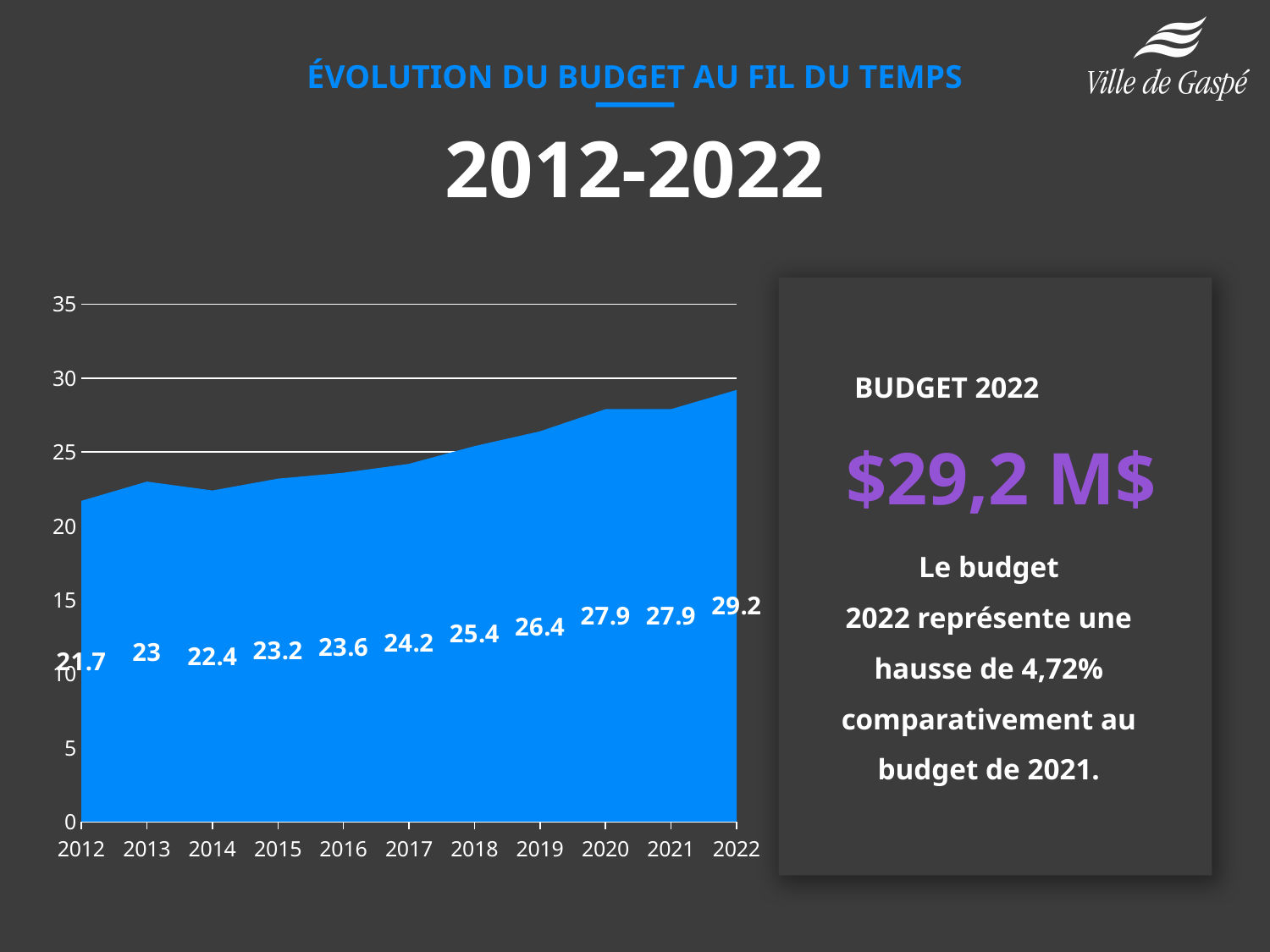
Which year has the lowest budget value? 2012 What is the difference between the budget values for 2022 and 2021? 1.3 What is the budget value shown for 2022? 29.2 What is the budget value shown for 2018? 25.4 What is the budget value shown for 2012? 21.7 Which is larger, the budget value for 2017 or for 2019? 2019 Is the budget value for 2020 greater or less than 25? greater How many years are plotted on the x axis? 11 What kind of chart is shown on the slide? area chart Which year has the highest budget value? 2022 Do the budget values generally rise or fall from 2012 to 2022? rise What is the difference between the budget values for 2013 and 2014? 0.6